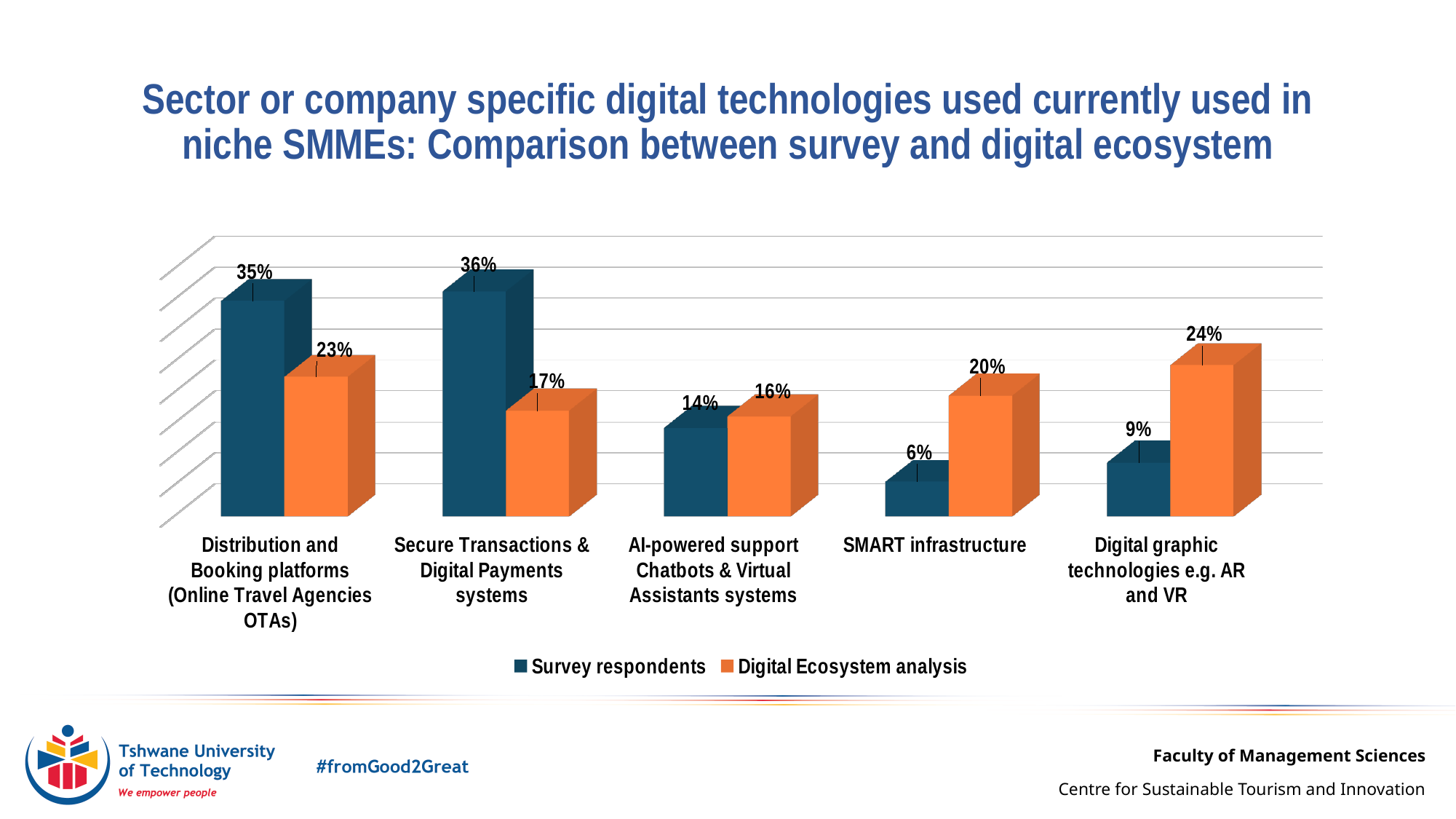
For AI-powered support Chatbots & Virtual Assistants systems, which series has the larger value? Digital Ecosystem analysis How many series does the legend list? 2 What is the Survey respondents value for Digital graphic technologies e.g. AR and VR? 9% Which category has the highest Digital Ecosystem analysis value? Digital graphic technologies e.g. AR and VR What is the Survey respondents value for Secure Transactions & Digital Payments systems? 36% What is the Digital Ecosystem analysis value for SMART infrastructure? 20% What kind of chart is shown on the slide? Bar chart Which category has the highest Survey respondents value? Secure Transactions & Digital Payments systems How many categories are shown on the x axis? 5 What is the Digital Ecosystem analysis value for Distribution and Booking platforms (Online Travel Agencies OTAs)? 23% Which category has the lowest Survey respondents value? SMART infrastructure What is the difference between the Survey respondents and Digital Ecosystem analysis values for Secure Transactions & Digital Payments systems? 19%